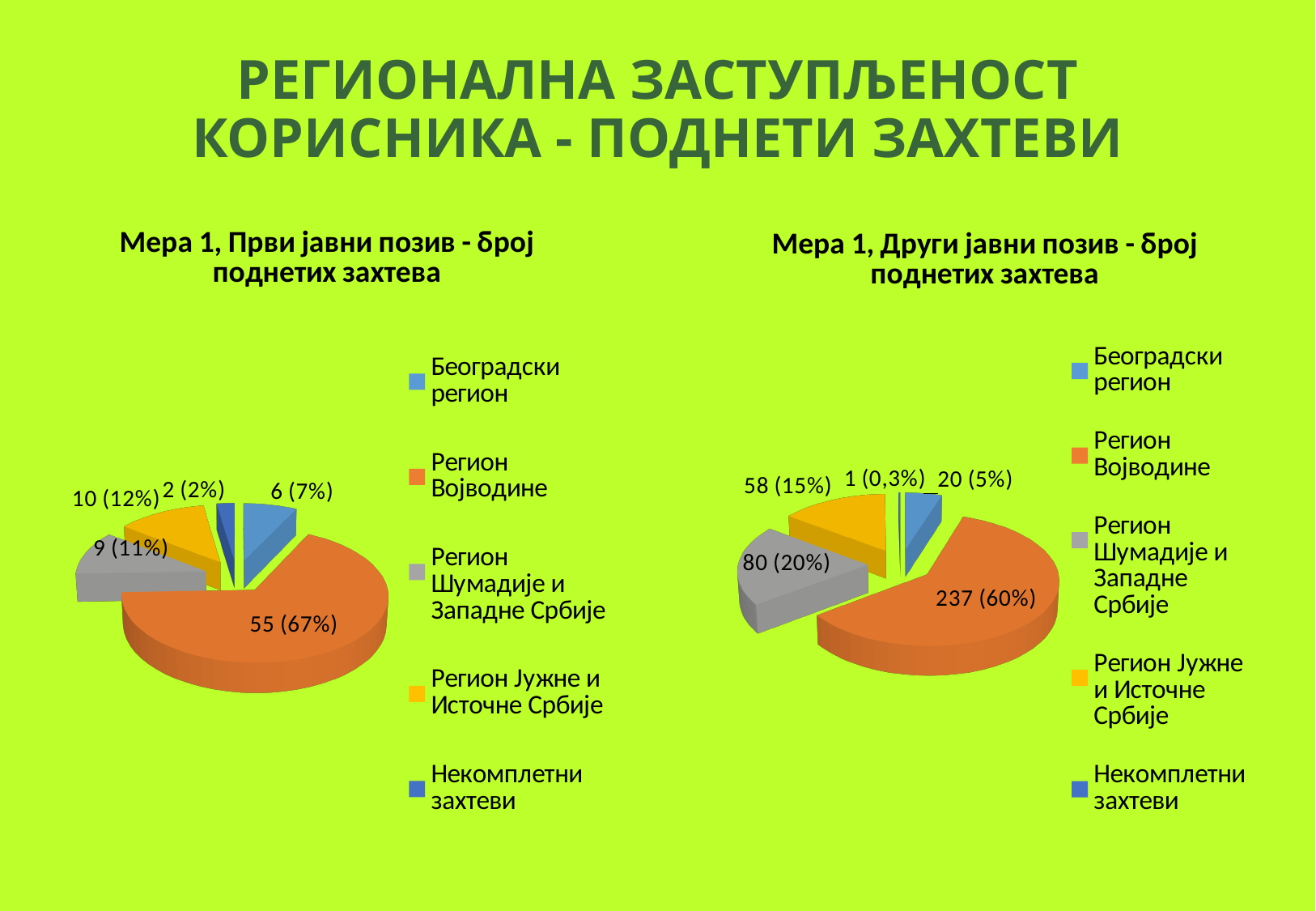
How many categories does the legend of the chart titled "Мера 1, Други јавни позив - број поднетих захтева" list? 5 In the chart titled "Мера 1, Први јавни позив - број поднетих захтева", what is the difference between the counts for Регион Јужне и Источне Србије and Регион Шумадије и Западне Србије? 1 In the chart titled "Мера 1, Други јавни позив - број поднетих захтева", which is larger: Регион Шумадије и Западне Србије or Регион Јужне и Источне Србије? Регион Шумадије и Западне Србије In the chart titled "Мера 1, Први јавни позив - број поднетих захтева", what share of the pie does Регион Јужне и Источне Србије have? 12% In the chart titled "Мера 1, Први јавни позив - број поднетих захтева", what is the value for Београдски регион? 6 (7%) In the chart titled "Мера 1, Други јавни позив - број поднетих захтева", what share of the pie does Некомплетни захтеви have? 0,3% What type of chart is the chart titled "Мера 1, Први јавни позив - број поднетих захтева"? Pie chart In the chart titled "Мера 1, Други јавни позив - број поднетих захтева", what is the value for Регион Војводине? 237 (60%) In the chart titled "Мера 1, Први јавни позив - број поднетих захтева", what is the value for Регион Војводине? 55 (67%) In the chart titled "Мера 1, Први јавни позив - број поднетих захтева", which category has the smallest slice? Некомплетни захтеви In the chart titled "Мера 1, Други јавни позив - број поднетих захтева", which category has the largest slice? Регион Војводине In the chart titled "Мера 1, Други јавни позив - број поднетих захтева", what is the value for Регион Шумадије и Западне Србије? 80 (20%)